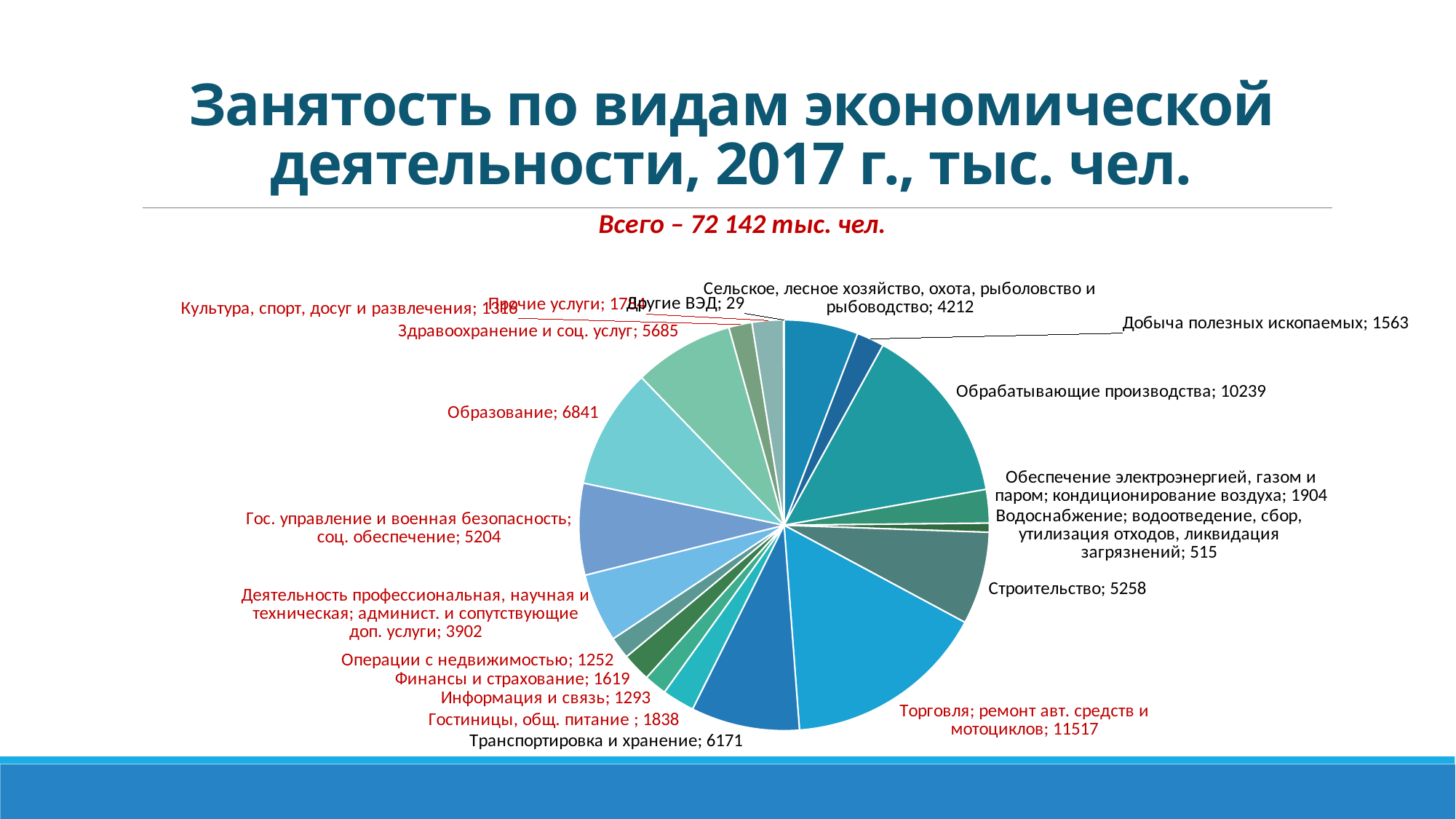
What is the value for Обрабатывающие производства? 10239 What total number of employed people (тыс. чел.) is stated on the slide? 72 142 тыс. чел. What is the value for Образование? 6841 Which category has the smallest slice of the pie? Другие ВЭД What kind of chart is shown on the slide? Pie chart Which category has the largest slice of the pie? Торговля; ремонт авт. средств и мотоциклов What is the value for Строительство? 5258 What is the value for Транспортировка и хранение? 6171 What year does the chart title refer to? 2017 Which is larger: Транспортировка и хранение or Образование? Образование What is the difference between the values for Торговля; ремонт авт. средств и мотоциклов and Обрабатывающие производства? 1278 What is the difference between the values for Образование and Здравоохранение и соц. услуг? 1156